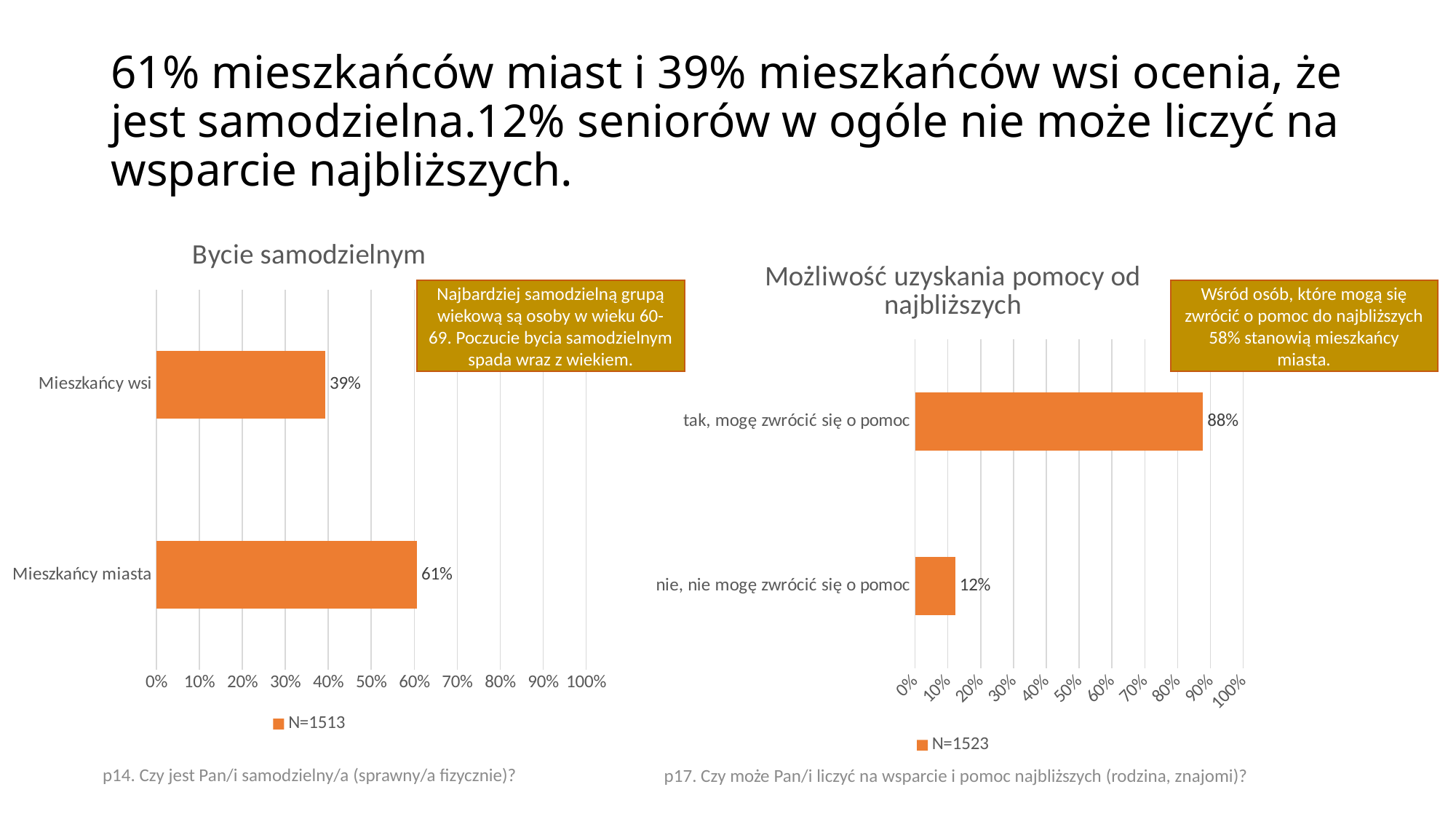
How many categories does the 'Możliwość uzyskania pomocy od najbliższych' chart show? 2 In the 'Bycie samodzielnym' chart, what is the value for Mieszkańcy miasta? 61% In the 'Możliwość uzyskania pomocy od najbliższych' chart, what is the value for 'nie, nie mogę zwrócić się o pomoc'? 12% In the 'Bycie samodzielnym' chart, which category has the higher value? Mieszkańcy miasta In the 'Bycie samodzielnym' chart, what is the value for Mieszkańcy wsi? 39% What is the legend entry of the 'Bycie samodzielnym' chart? N=1513 In the 'Bycie samodzielnym' chart, what is the difference between Mieszkańcy miasta and Mieszkańcy wsi? 22% What type of chart is the 'Bycie samodzielnym' chart? bar chart In the 'Możliwość uzyskania pomocy od najbliższych' chart, what is the value for 'tak, mogę zwrócić się o pomoc'? 88% In the 'Możliwość uzyskania pomocy od najbliższych' chart, which category has the lowest value? nie, nie mogę zwrócić się o pomoc In the 'Bycie samodzielnym' chart, is the value for Mieszkańcy wsi greater or less than 50%? less In the 'Możliwość uzyskania pomocy od najbliższych' chart, what is the difference between the 'tak' and 'nie' values? 76%